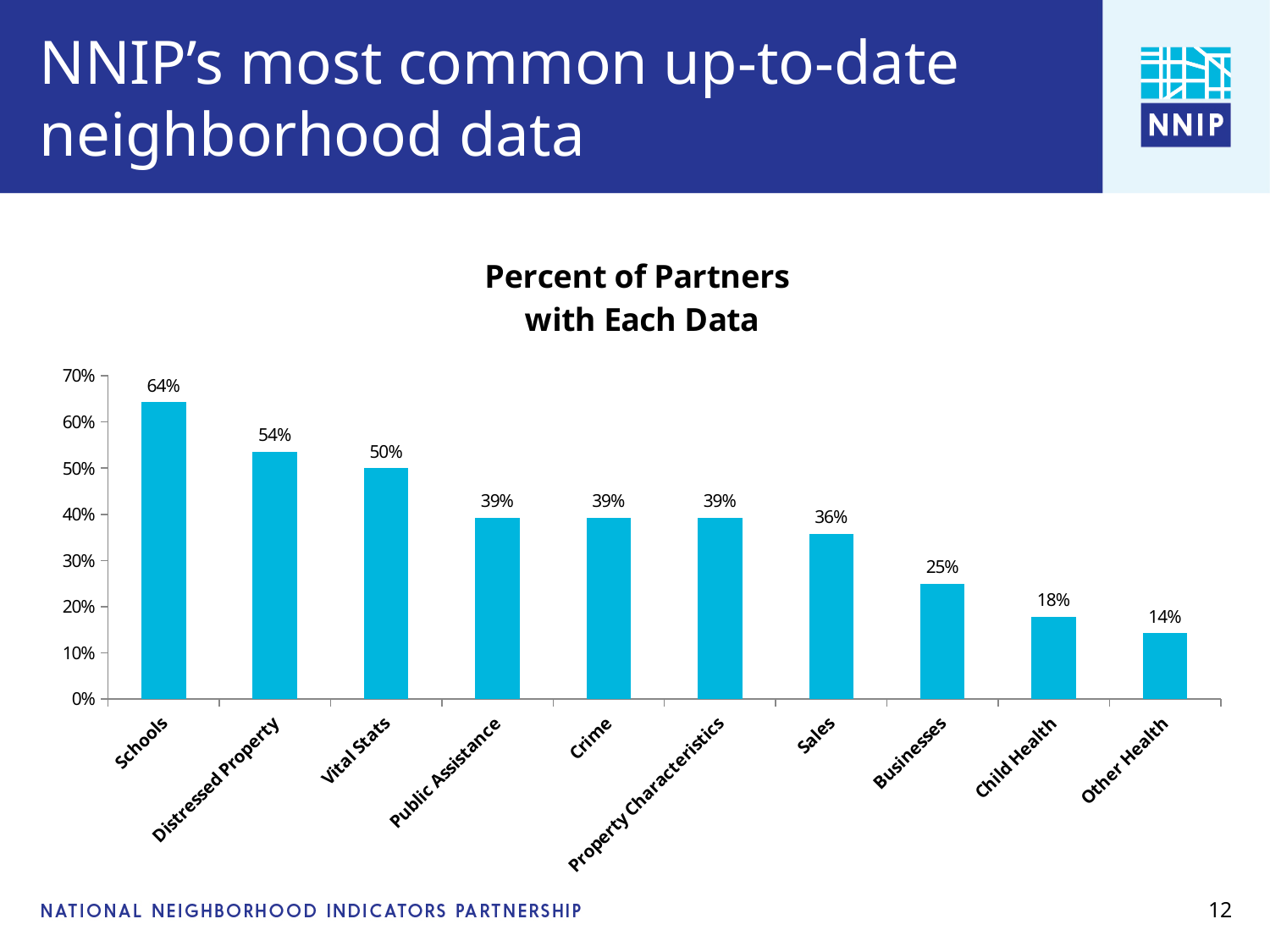
What percent of partners have Child Health data? 18% What is the value for Businesses? 25% Do the values rise or fall moving from left to right along the x axis? Fall Which is larger, the value for Vital Stats or the value for Sales? Vital Stats What is the title of the chart? Percent of Partners with Each Data How many categories are shown on the x axis? 10 What is the difference between the values for Schools and Distressed Property? 10% Which category has the highest percent of partners? Schools Which category has the lowest percent of partners? Other Health What percent of partners have Schools data? 64% What kind of chart is shown on the slide? Bar chart What is the difference between the values for Sales and Other Health? 22%